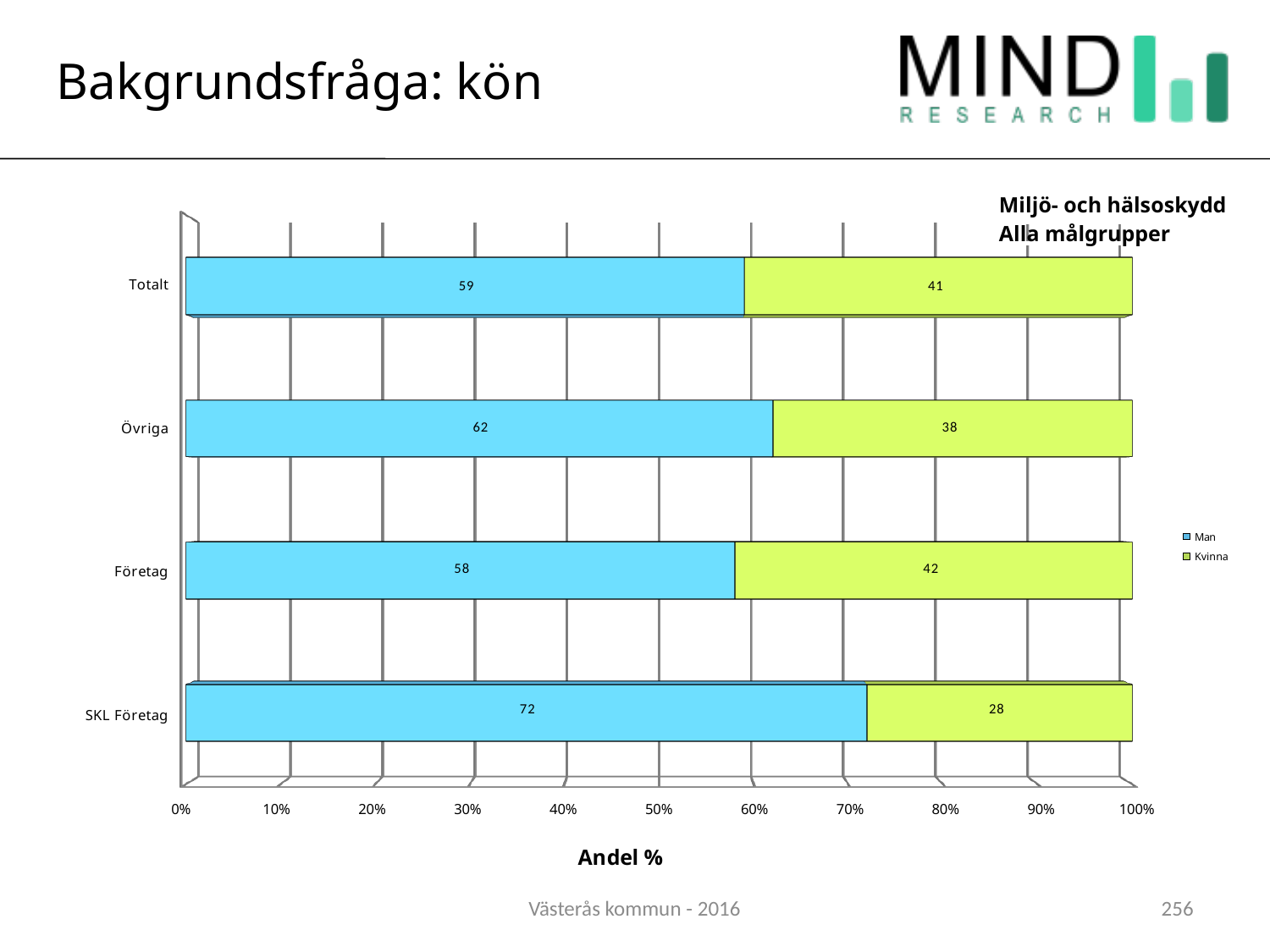
Which is larger for Övriga: the Man value or the Kvinna value? Man What kind of chart is shown on the slide? Stacked bar chart What is the label of the x axis? Andel % How many categories are shown on the y axis? 4 Which category has the lowest value for Kvinna? SKL Företag What is the difference between the Man and Kvinna values for Företag? 16 What is the total of the stacked bar for SKL Företag? 100 What is the value for Kvinna in the Övriga category? 38 Which category has the highest value for Man? SKL Företag How many series does the legend list? 2 What is the value for Man in the Totalt category? 59 What is the value for Kvinna in the SKL Företag category? 28